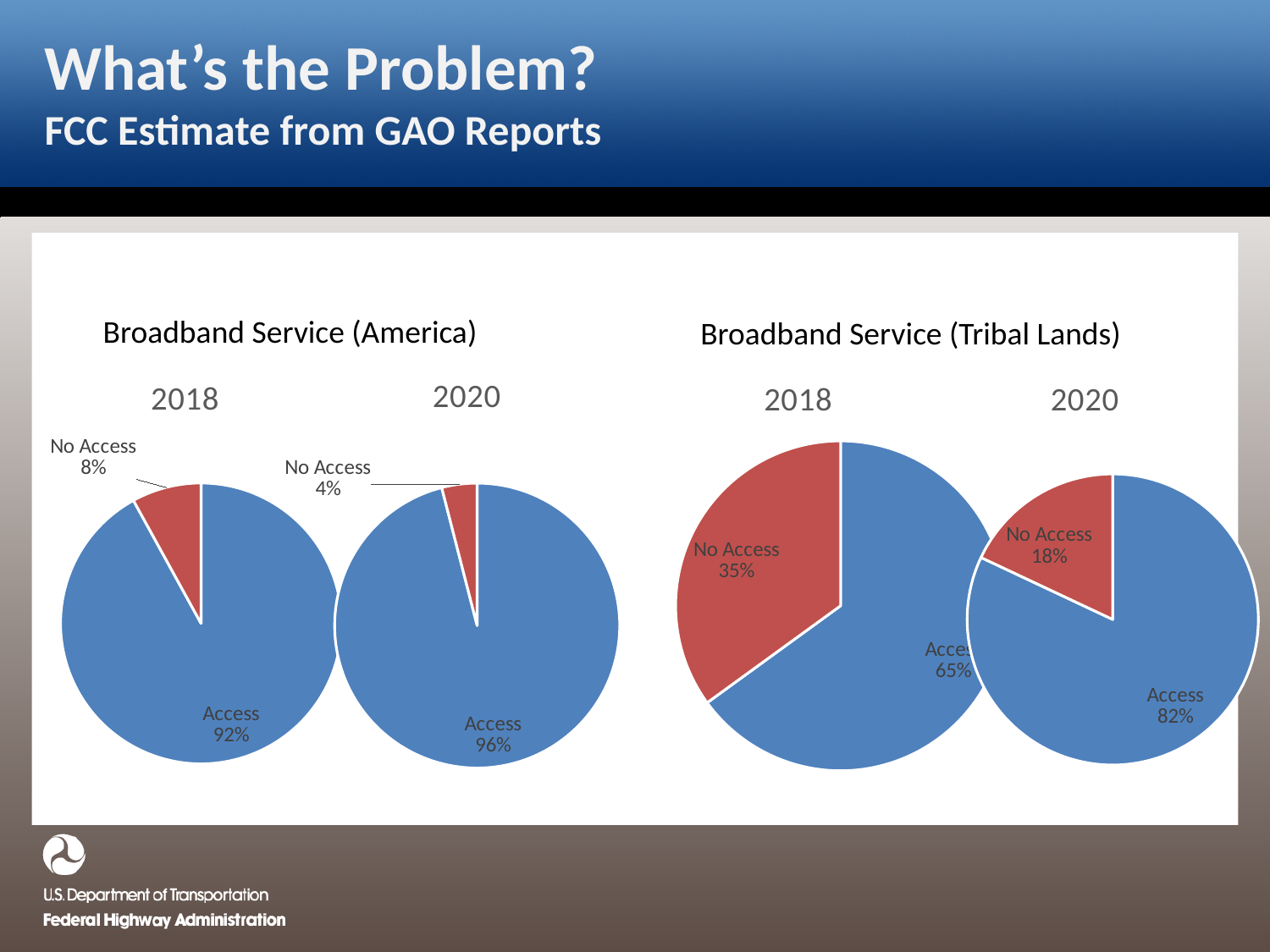
What kind of chart is used to show Broadband Service (America) for 2018? Pie chart How many slices does the Broadband Service (Tribal Lands) 2020 pie chart have? 2 In the Broadband Service (America) 2018 pie chart, which slice is the smallest? No Access In the Broadband Service (Tribal Lands) 2020 pie chart, what share has Access? 82% What is the difference between the No Access share in the Tribal Lands 2018 pie and the No Access share in the Tribal Lands 2020 pie? 17% In the Broadband Service (Tribal Lands) 2018 pie chart, what share has No Access? 35% In the Broadband Service (Tribal Lands) 2018 pie chart, which slice is larger, Access or No Access? Access What is the difference between the Access share in the America 2020 pie and the Access share in the Tribal Lands 2020 pie? 14% In the Broadband Service (America) 2020 pie chart, what share has Access? 96% What colour is the No Access slice in the Broadband Service (Tribal Lands) 2018 pie chart? Red How many pie charts are shown on the slide in total? 4 In the Broadband Service (America) 2018 pie chart, what share has No Access? 8%